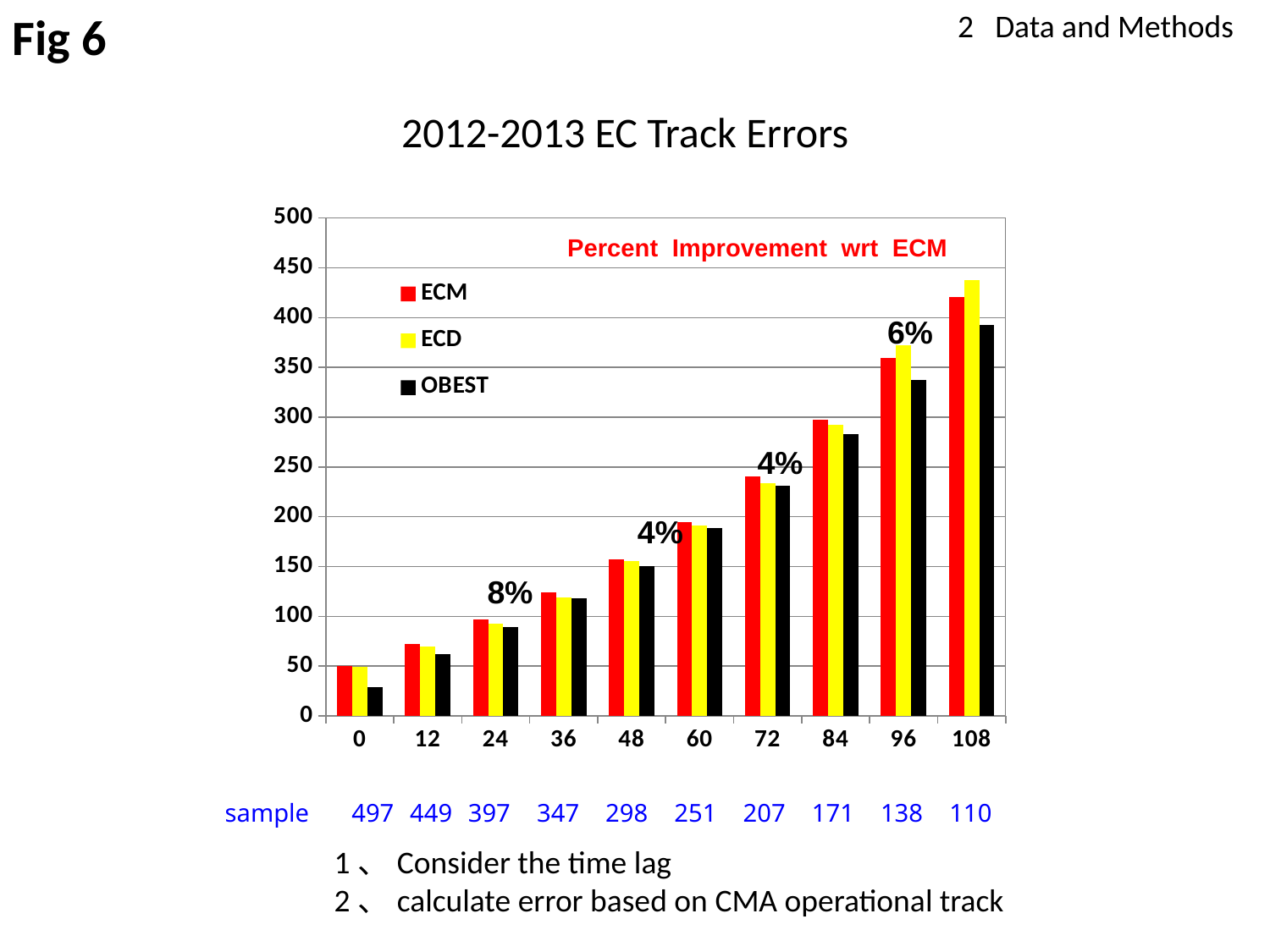
Which colour represents the OBEST series? black What percent improvement wrt ECM is annotated at 24 hours? 8% Is the OBEST value at 0 hours greater or less than 50? less At 108 hours, which is larger, the ECD value or the OBEST value? ECD What kind of chart is shown on the slide? bar chart How many forecast-hour categories are shown on the x axis? 10 What is the title of the chart? 2012-2013 EC Track Errors At which forecast hour is the OBEST track error lowest? 0 At which forecast hour is the ECM track error highest? 108 Is the ECM value at 108 hours greater or less than 400? greater How many series does the legend list? 3 Do the ECM track errors rise or fall as the forecast hour increases along the x axis? rise